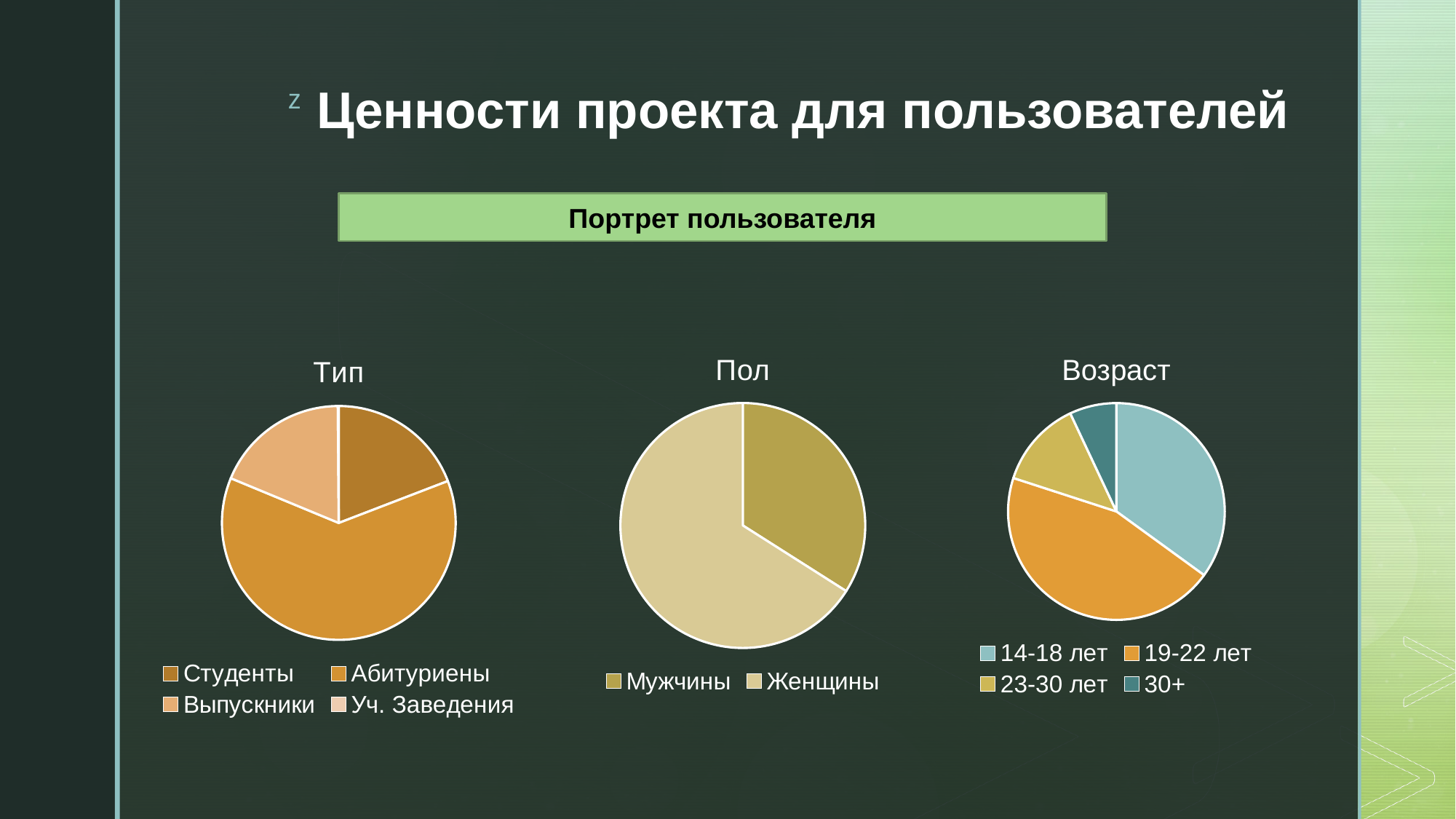
How many pie charts are shown on the slide? 3 How many age groups does the legend of the "Возраст" chart list? 4 In the "Пол" chart, which category has the largest slice? Женщины In the "Пол" chart, which category has the smallest slice? Мужчины In the "Тип" chart, which category has the largest slice? Абитуриены In the "Возраст" chart, which age group has the largest slice? 19-22 лет How many categories does the legend of the "Пол" chart list? 2 How many categories does the legend of the "Тип" chart list? 4 What kind of chart is the "Тип" chart? pie chart In the "Возраст" chart, which slice is larger: 19-22 лет or 23-30 лет? 19-22 лет In the "Возраст" chart, which age group has the smallest slice? 30+ In the "Тип" chart, which slice is larger: Абитуриены or Студенты? Абитуриены